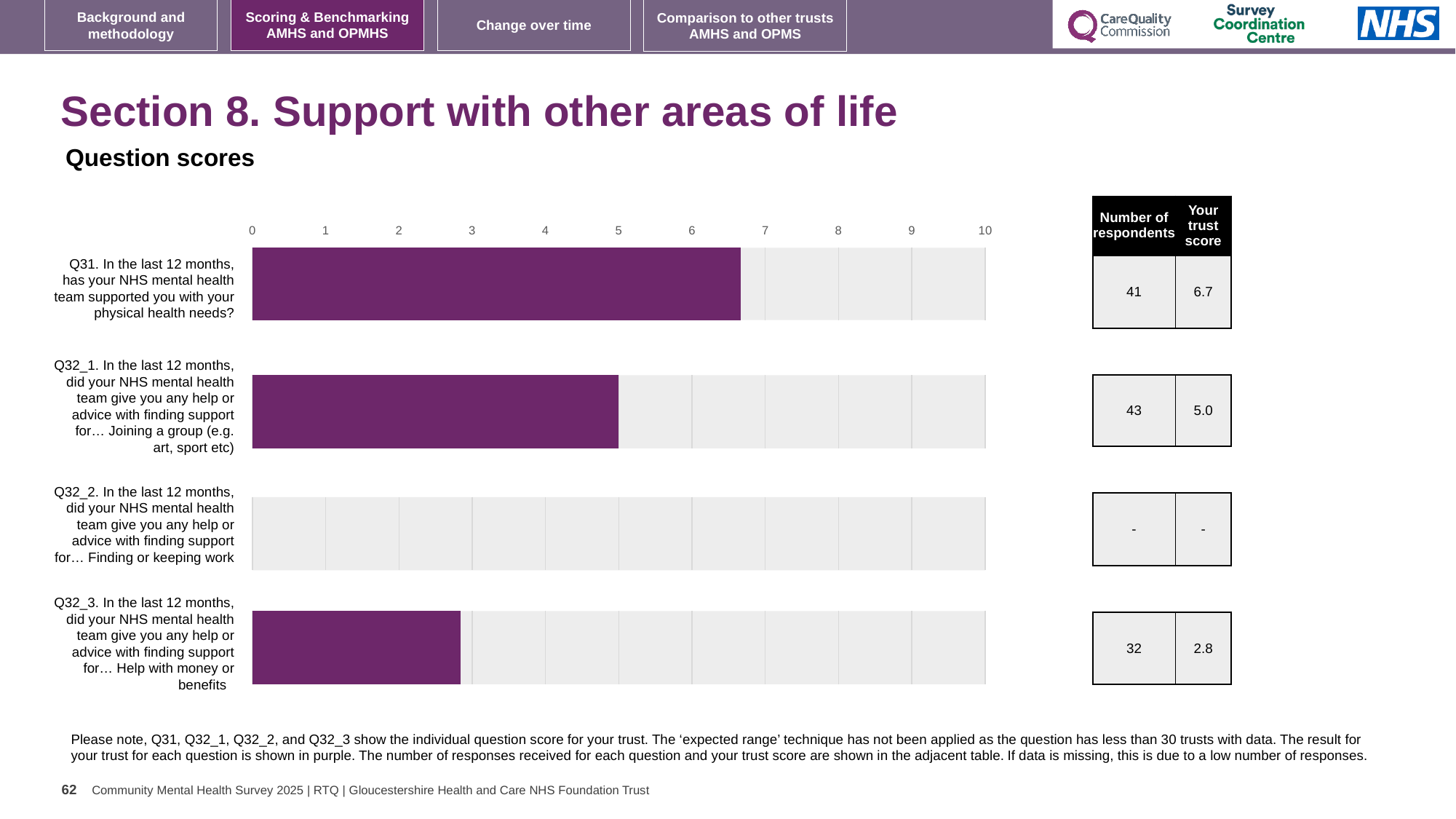
What is the trust score for Q31 (supported you with your physical health needs)? 6.7 What is the difference between the trust scores for Q31 and Q32_3? 3.9 What is the trust score for Q32_3 (help with money or benefits)? 2.8 Which question has the highest trust score? Q31 How many respondents answered Q32_3? 32 Which has a higher trust score, Q32_1 or Q32_3? Q32_1 What type of chart is shown on the slide? Bar chart Is the trust score for Q31 greater or less than 6? greater Which question with a score shown has the lowest trust score? Q32_3 How many questions are listed on the chart? 4 What is the trust score for Q32_1 (help or advice with finding support for joining a group)? 5.0 How many respondents answered Q32_1? 43